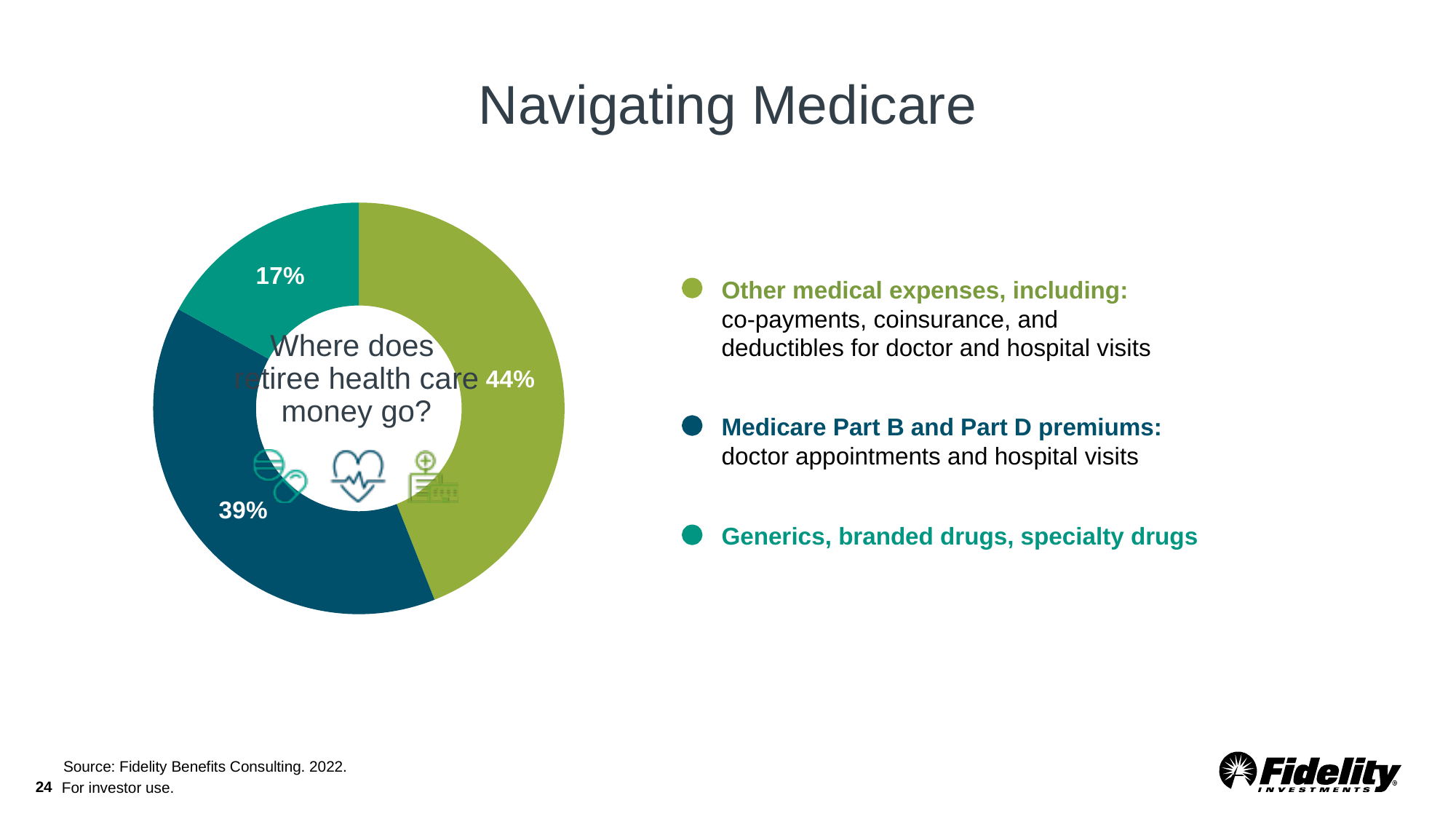
How many percentage points larger is the share for other medical expenses than the share for Medicare Part B and Part D premiums? 5 What share of retiree health care money goes to generics, branded drugs, and specialty drugs? 17% Which category takes the largest share of retiree health care money? Other medical expenses What colour is the slice representing generics, branded drugs, and specialty drugs? Teal What question is written in the centre of the donut chart? Where does retiree health care money go? What share of retiree health care money goes to Medicare Part B and Part D premiums? 39% How many percentage points larger is the share for Medicare Part B and Part D premiums than the share for generics, branded drugs, and specialty drugs? 22 Which category takes the smallest share of retiree health care money? Generics, branded drugs, specialty drugs What kind of chart is shown on the slide? Donut (pie) chart What share of retiree health care money goes to other medical expenses, including co-payments, coinsurance, and deductibles? 44% How many slices does the donut chart have? 3 Which is larger: the share for Medicare Part B and Part D premiums or the share for generics, branded drugs, and specialty drugs? Medicare Part B and Part D premiums